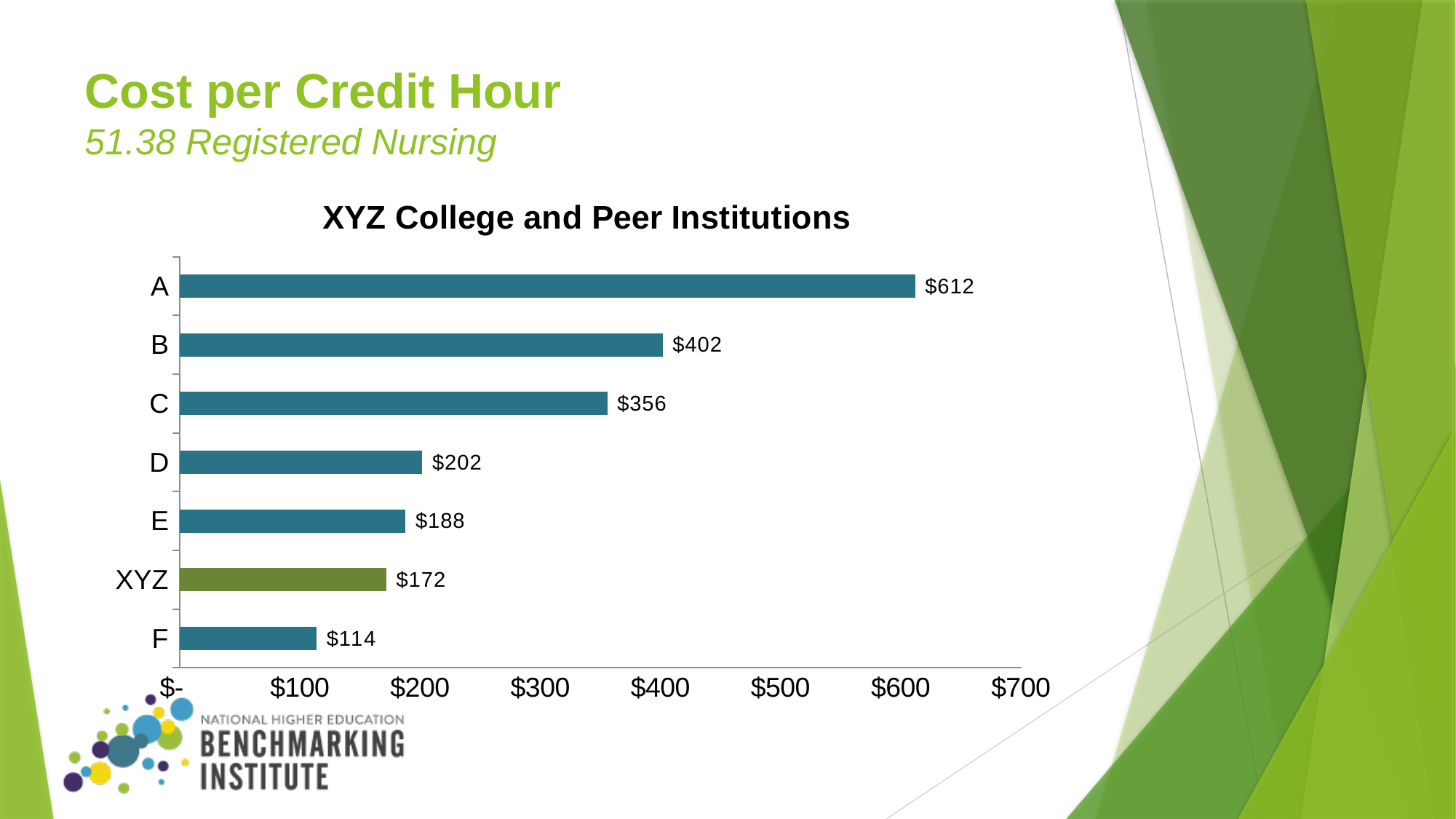
Which has a higher cost per credit hour, institution D or institution E? D What is the cost per credit hour for XYZ? $172 What is the difference in cost per credit hour between institution A and institution B? $210 Is the cost per credit hour for institution B greater or less than $400? greater What is the title of the chart? XYZ College and Peer Institutions What is the difference in cost per credit hour between institution E and XYZ? $16 Which institution has the lowest cost per credit hour? F Which institution has the highest cost per credit hour? A What is the cost per credit hour for institution A? $612 What type of chart is shown on the slide? Bar chart What is the cost per credit hour for institution C? $356 How many institutions are shown in the chart? 7